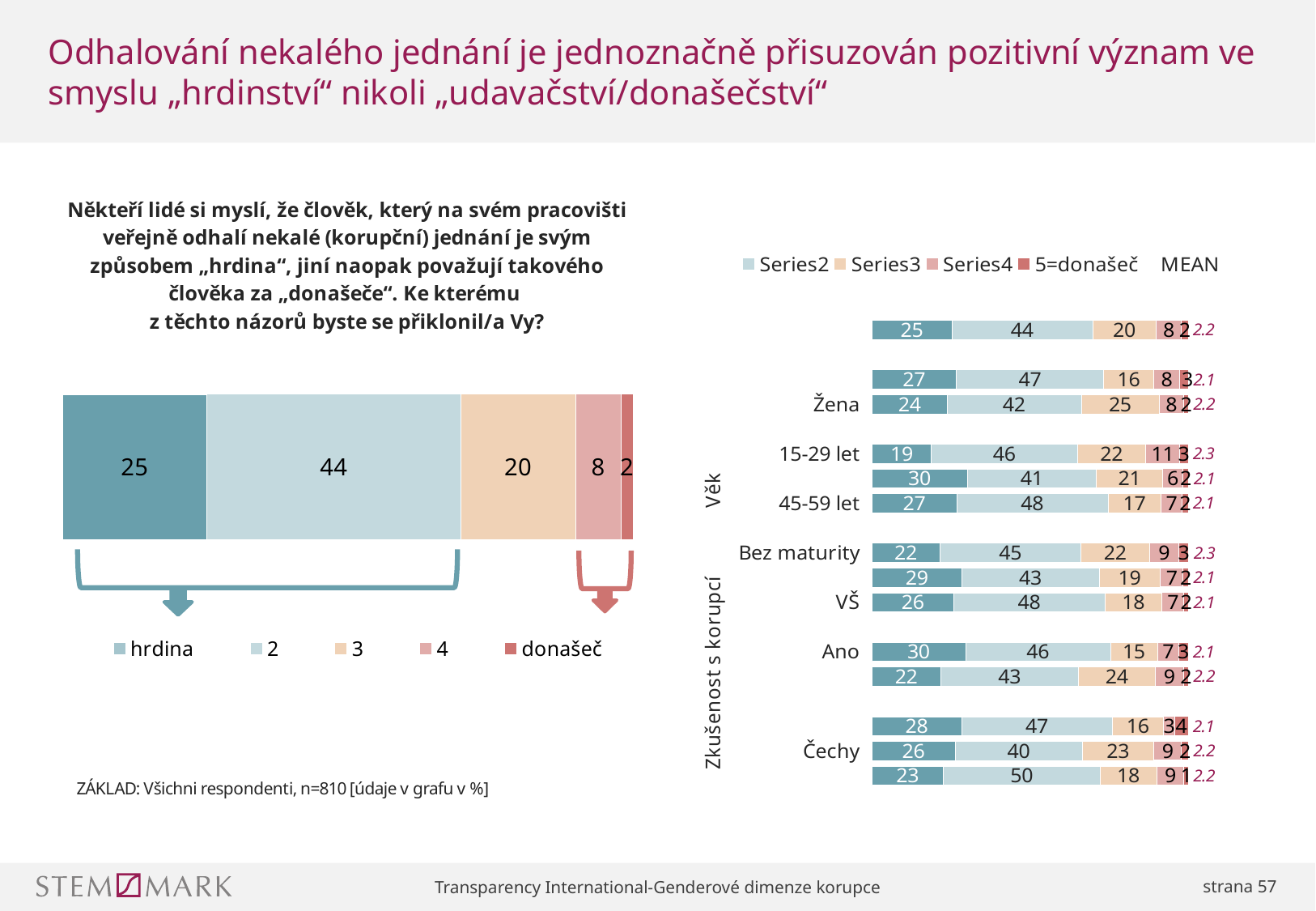
How many entries does the legend of the left chart list? 5 In the right chart, which has the larger leftmost (dark teal) segment: "Žena" or "45-59 let"? 45-59 let In the right chart, which has the higher MEAN value: "Bez maturity" or "VŠ"? Bez maturity In the left chart, which legend category has the largest value? 2 In the right chart, what is the MEAN value shown for "VŠ"? 2.1 In the left chart, what is the difference between the value for "hrdina" and the value for "3"? 5 In the right chart, what is the MEAN value shown for "15-29 let"? 2.3 What kind of chart is the left chart? bar chart According to the note under the left chart, how many respondents form the base (n)? 810 In the left chart, what is the value for "hrdina"? 25 In the right chart, what is the value of the leftmost (dark teal) segment for "Ano"? 30 In the right chart, what is the value of the second (light blue) segment for "Čechy"? 40